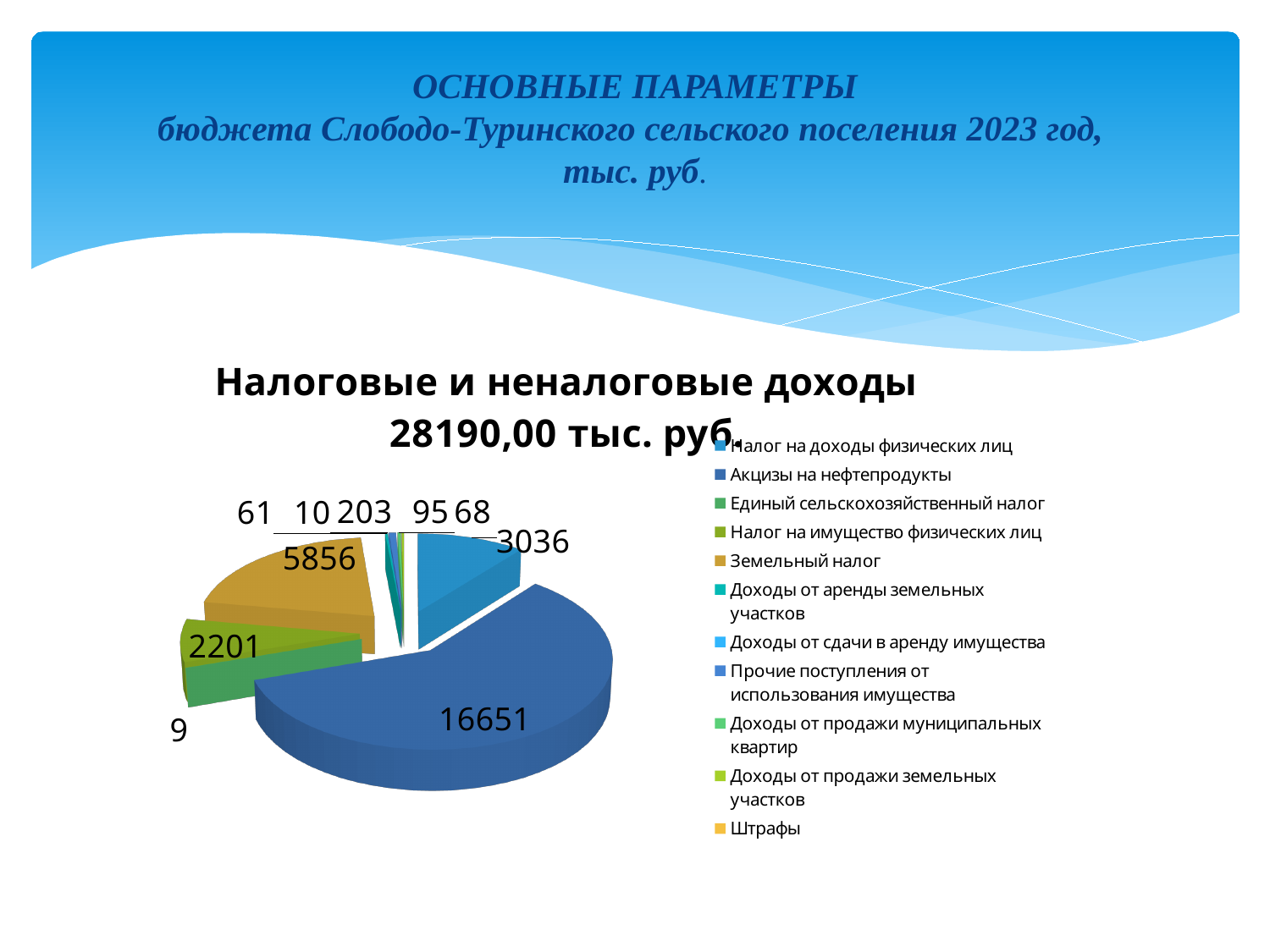
Which is larger: Земельный налог or Налог на доходы физических лиц? Земельный налог What is the value for Акцизы на нефтепродукты? 16651 What is the difference between the values for Земельный налог and Налог на доходы физических лиц? 2820 Which category has the largest slice of the pie? Акцизы на нефтепродукты What kind of chart is shown on the slide? pie chart What is the value for Налог на доходы физических лиц? 3036 What total amount of tax and non-tax revenue is stated in the chart title? 28190,00 тыс. руб. What is the difference between the values for Акцизы на нефтепродукты and Налог на доходы физических лиц? 13615 What is the value for Земельный налог? 5856 What is the title of the chart? Налоговые и неналоговые доходы 28190,00 тыс. руб. What is the smallest data label shown on the pie chart? 9 How many entries does the chart legend list? 11